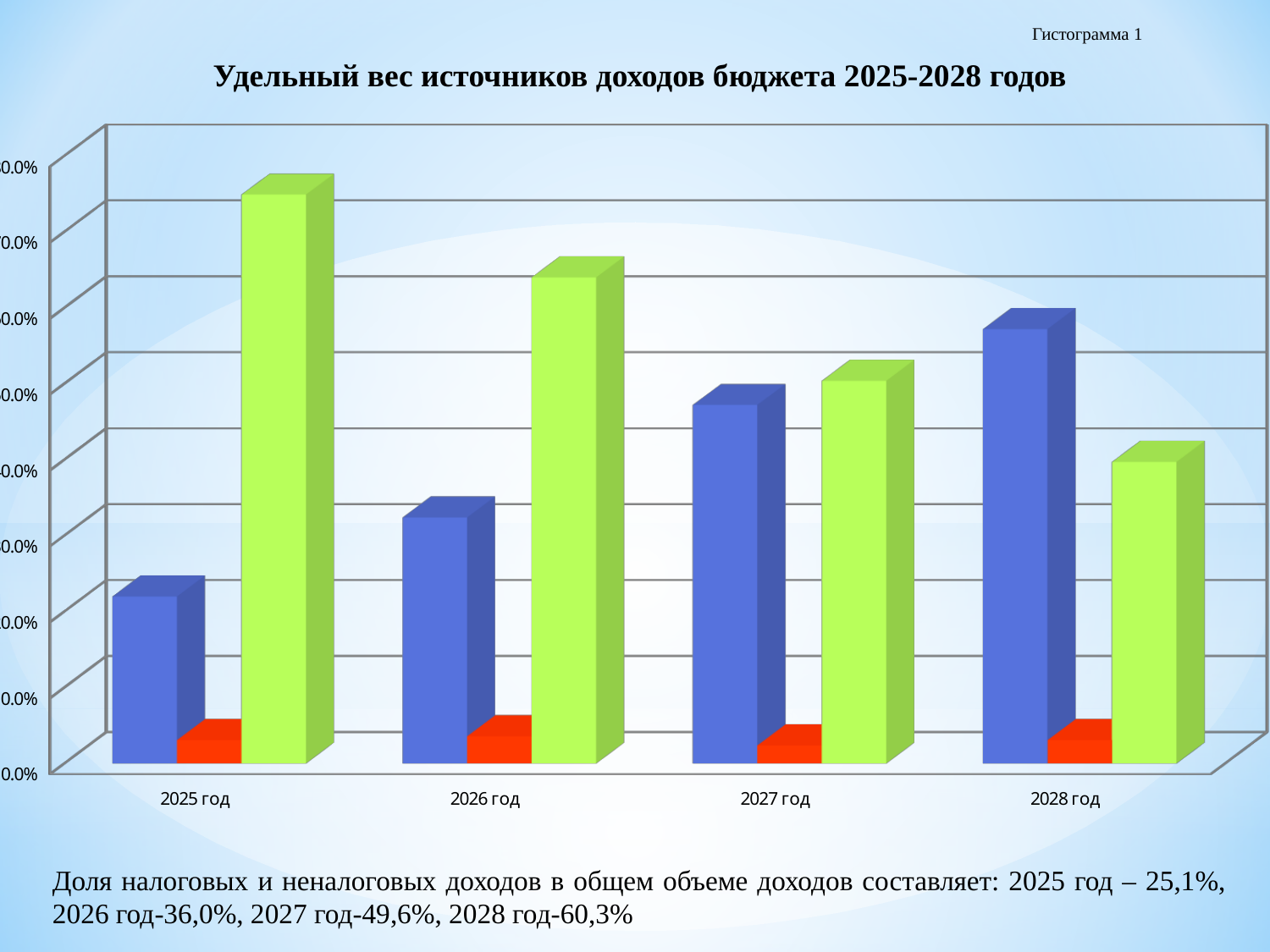
According to the text below the chart, what is the share of tax and non-tax revenues in total revenues for 2027 год? 49,6% Is the value of the green bar for 2025 год greater or less than 70.0%? greater What is the title of the chart? Удельный вес источников доходов бюджета 2025-2028 годов Which year has the tallest green bar? 2025 год Do the green bars rise or fall from 2025 год to 2028 год? fall How many year categories are shown on the x axis of the chart? 4 Do the blue bars rise or fall from 2025 год to 2028 год? rise Which year has the tallest blue bar? 2028 год For 2025 год, which bar is taller, the blue one or the green one? green How many bars are plotted for each year category? 3 What kind of chart is shown on the slide? bar chart Is the value of the red bar for 2026 год greater or less than 10.0%? less